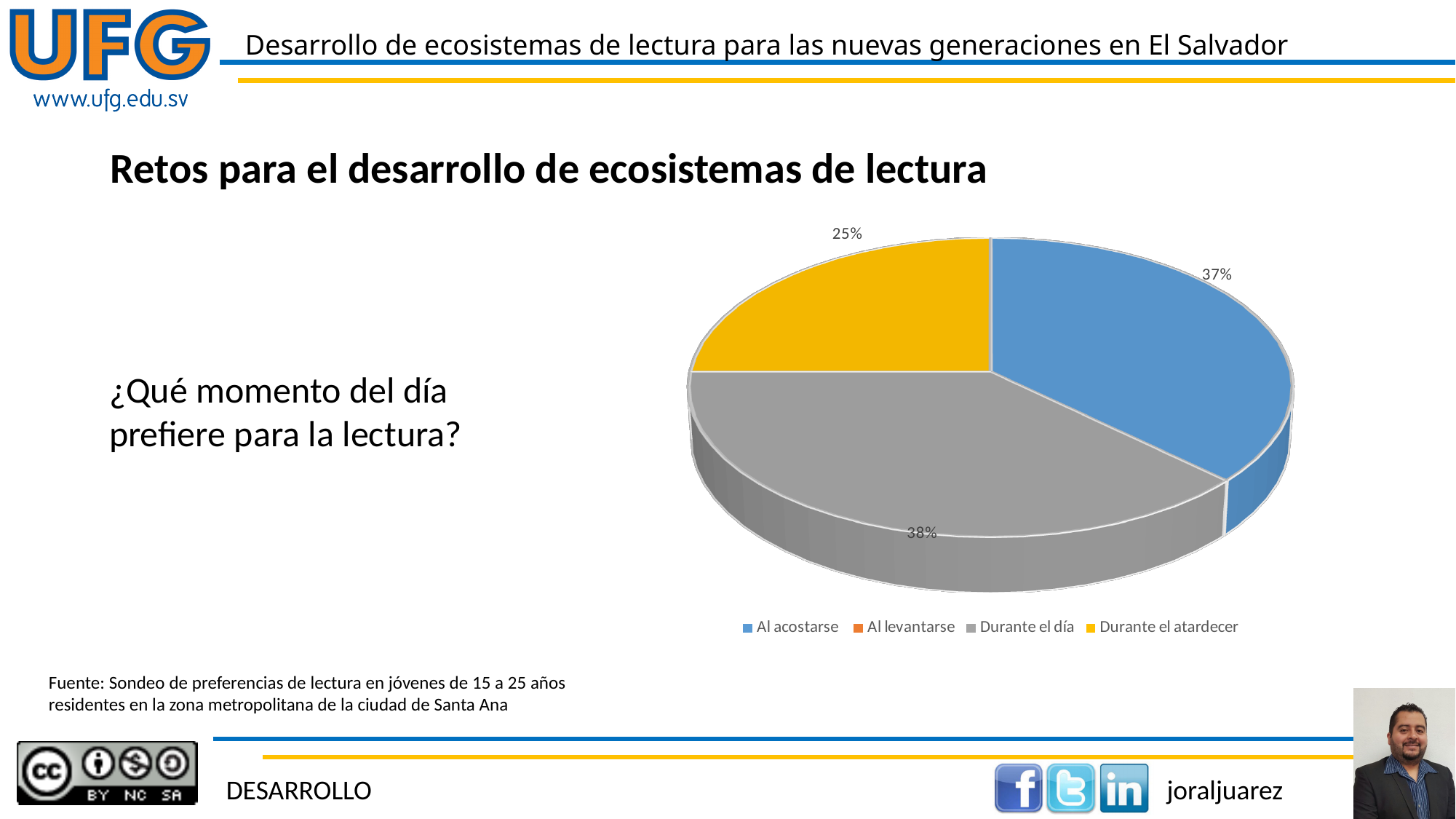
Which is larger: the share for "Al acostarse" or the share for "Durante el atardecer"? Al acostarse How many entries does the chart legend list? 4 Which is larger: the share for "Durante el día" or the share for "Durante el atardecer"? Durante el día What percentage is shown for "Durante el atardecer"? 25% What is the difference in percentage points between "Durante el día" and "Al acostarse"? 1 What kind of chart is shown on the slide? Pie chart What is the difference in percentage points between "Al acostarse" and "Durante el atardecer"? 12 What colour is the slice for "Durante el atardecer"? Yellow What share of the pie corresponds to "Durante el día"? 38% What percentage of respondents prefer reading "Al acostarse"? 37% Which legend entry is shown in gray? Durante el día Which labelled slice of the pie chart has the largest share? Durante el día